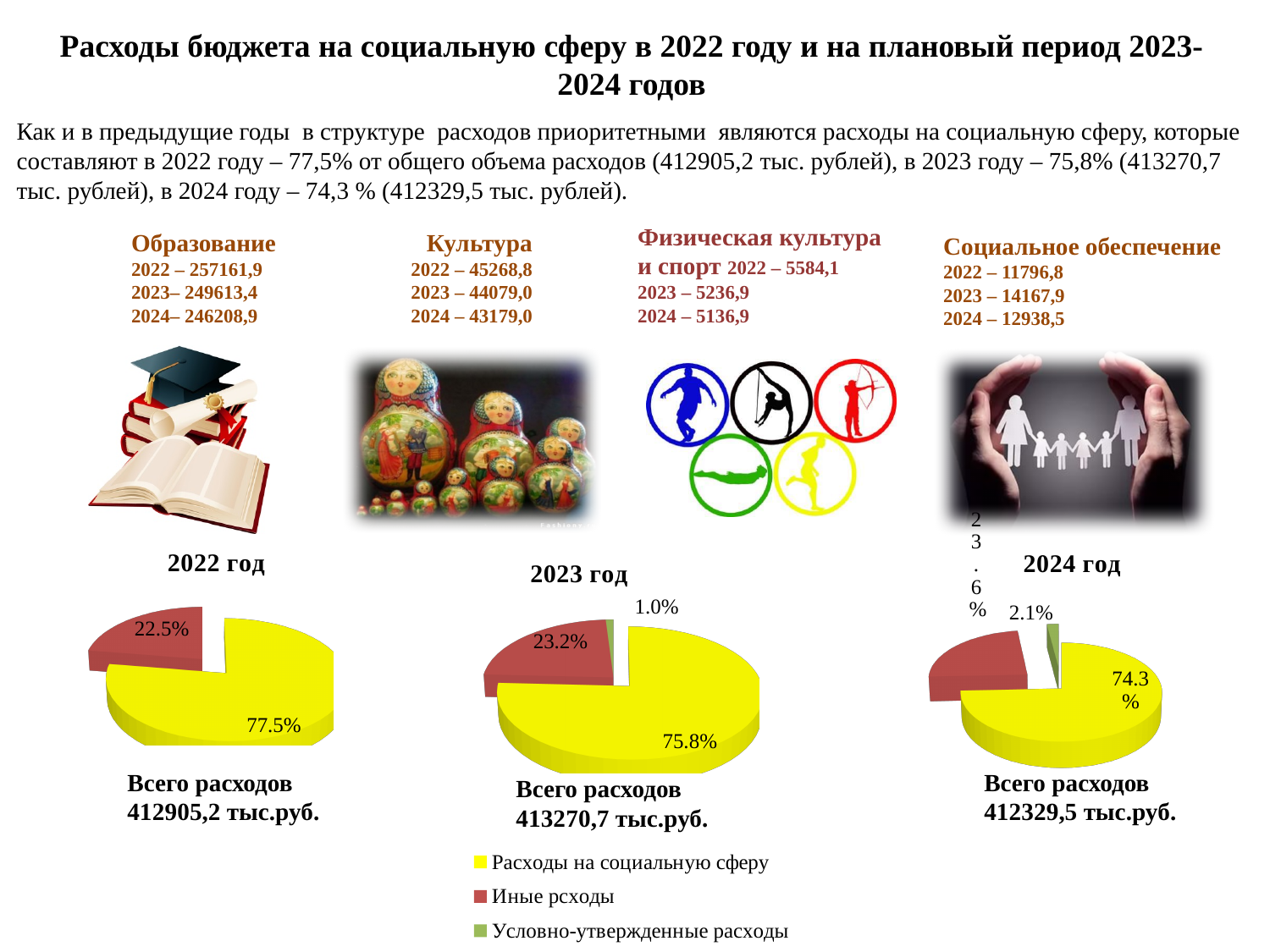
What is the difference in percentage points between the Расходы на социальную сферу share in the 2022 год chart and in the 2024 год chart? 3.2 In the 2024 год pie chart, what share is shown for Условно-утвержденные расходы? 2.1% In the 2023 год pie chart, which category has the largest slice? Расходы на социальную сферу What type of chart is used for 2022 год, 2023 год and 2024 год? Pie chart How many slices does the 2023 год pie chart have? 3 In the 2023 год pie chart, what share is shown for Условно-утвержденные расходы? 1.0% In the 2024 год pie chart, what share is shown for Расходы на социальную сферу? 74.3% In the 2022 год pie chart, what share is shown for Иные рсходы? 22.5% In the 2022 год pie chart, what share is shown for Расходы на социальную сферу? 77.5% How many series does the shared legend list for the pie charts? 3 In the 2023 год pie chart, what share is shown for Иные рсходы? 23.2% In the 2024 год pie chart, which category has the smallest slice? Условно-утвержденные расходы